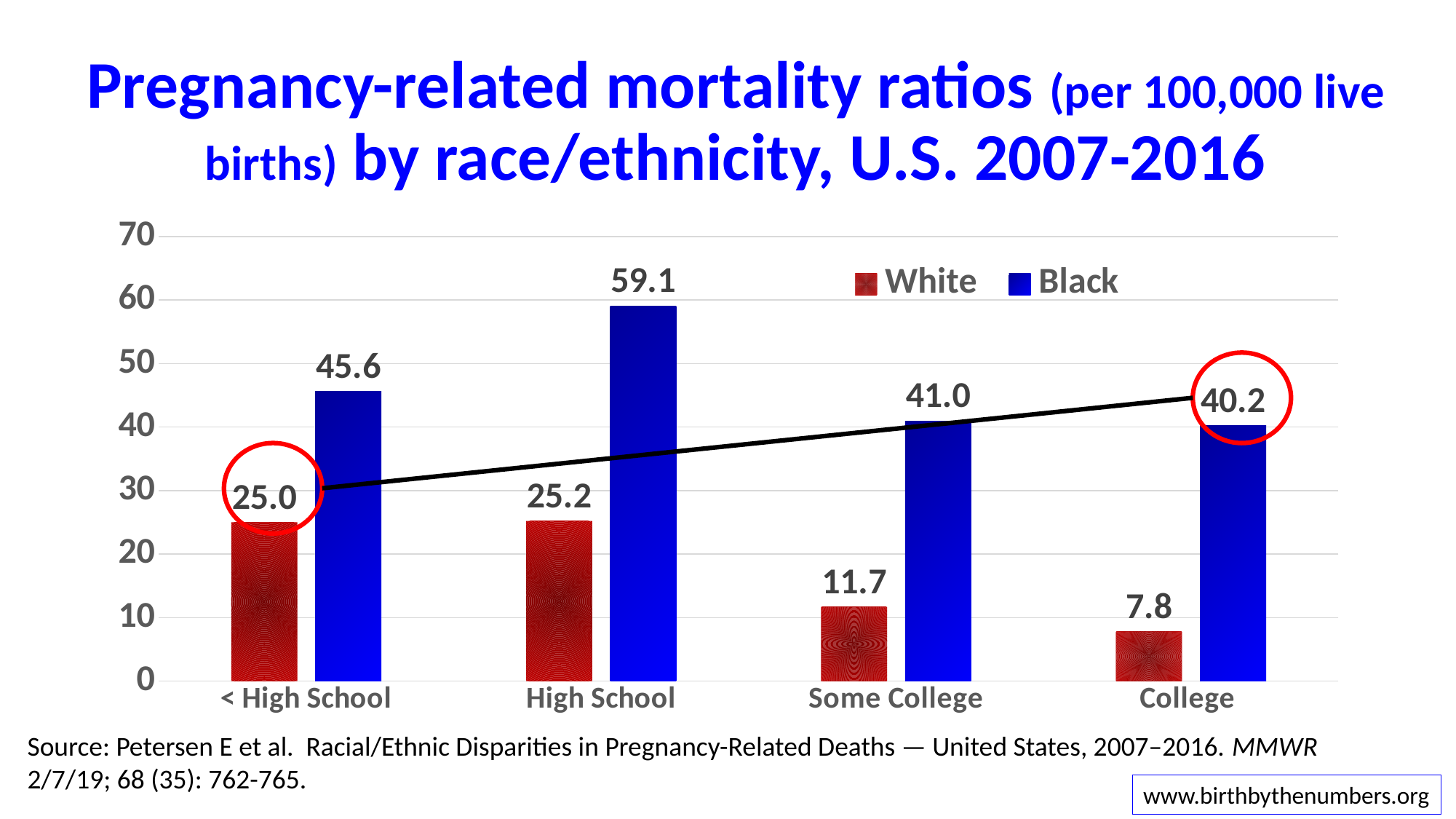
What is the pregnancy-related mortality ratio for Black women with a High School education? 59.1 How many series does the legend list? 2 Which is larger: the White value for < High School or the White value for High School? High School How many education categories are shown on the x axis? 4 Which colour represents the Black series in the chart? Blue What is the difference between the Black values for High School and Some College? 18.1 What is the pregnancy-related mortality ratio for White women with a College education? 7.8 Which education category has the highest value for Black women? High School What kind of chart is shown on the slide? Bar chart What is the difference between the Black and White values in the College category? 32.4 Which education category has the lowest value for White women? College What is the value for White women in the Some College category? 11.7